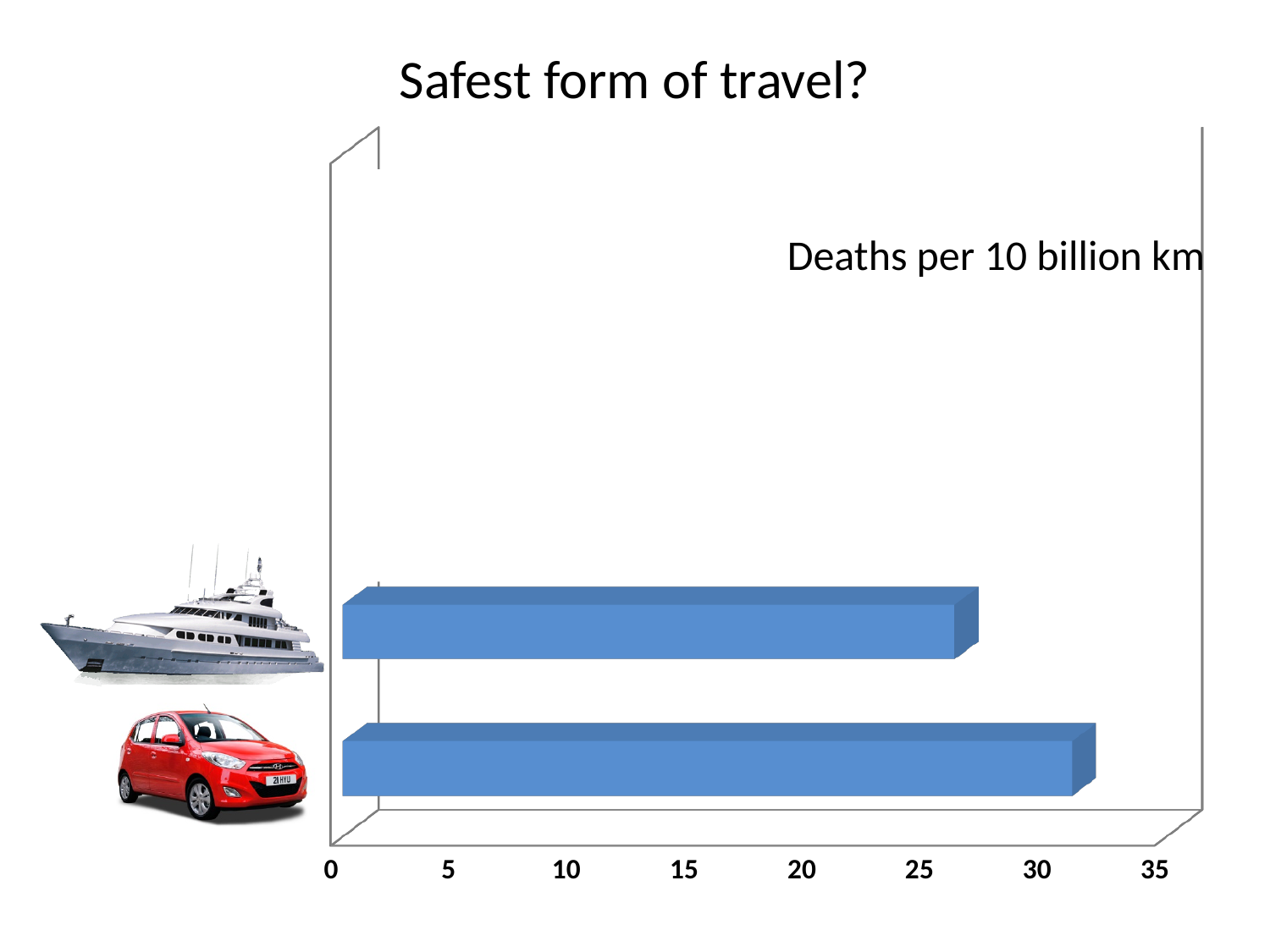
Which bar represents the highest value in the chart? the bottom bar (car) What is the highest value shown on the horizontal axis? 35 What does the text label inside the chart say the values measure? Deaths per 10 billion km Is the value for the bottom bar (car) greater or less than 35? less How many bars are plotted in the chart? 2 What is the title of the slide above the chart? Safest form of travel? Is the value for the bottom bar (car) greater or less than 25? greater Which bar is longer, the top bar (next to the boat image) or the bottom bar (next to the car image)? the bottom bar (car) What kind of chart is shown on the slide? bar chart Which bar represents the lowest value in the chart? the top bar (boat) Is the value for the top bar (boat) greater or less than 30? less